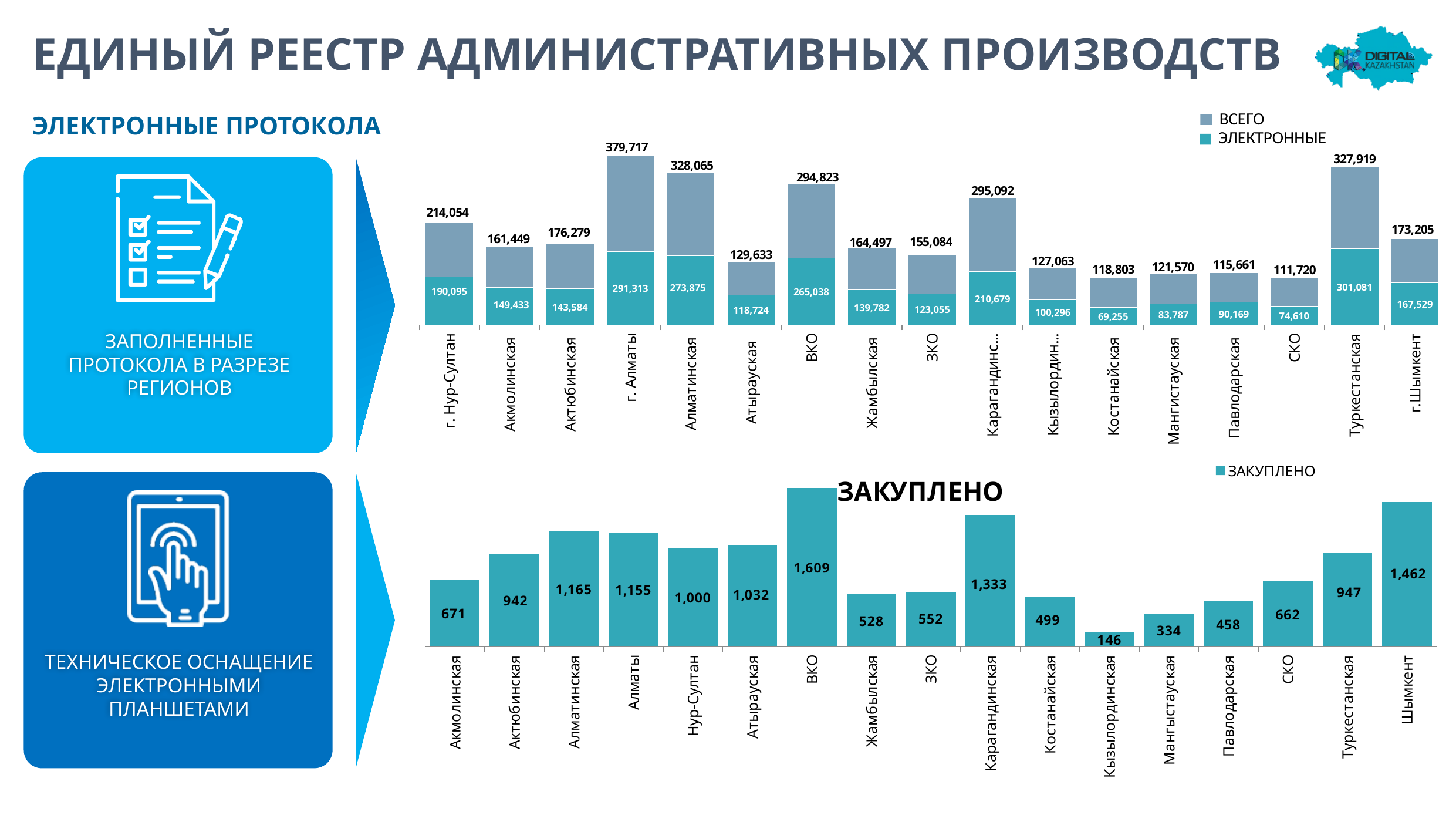
In the bottom chart (ЗАКУПЛЕНО), what is the difference between the values for Шымкент and Туркестанская? 515 In the top chart, which is larger: the ВСЕГО value for ВКО or the ВСЕГО value for Алматинская? Алматинская How many regions are shown in the bottom chart (ЗАКУПЛЕНО)? 17 In the top chart, which region has the lowest ЭЛЕКТРОННЫЕ value? Костанайская In the bottom chart (ЗАКУПЛЕНО), which region has the highest value? ВКО In the bottom chart (ЗАКУПЛЕНО), what is the value for Карагандинская? 1,333 In the top chart, what is the ЭЛЕКТРОННЫЕ value for Туркестанская? 301,081 How many series does the legend of the top chart list? 2 In the top chart, which region has the highest ВСЕГО value? г. Алматы In the top chart, what is the difference between the ВСЕГО and ЭЛЕКТРОННЫЕ values for г. Нур-Султан? 23,959 In the top chart (ЭЛЕКТРОННЫЕ ПРОТОКОЛА), what is the ВСЕГО value for г. Алматы? 379,717 In the bottom chart (ЗАКУПЛЕНО), which region has the lowest value? Кызылординская